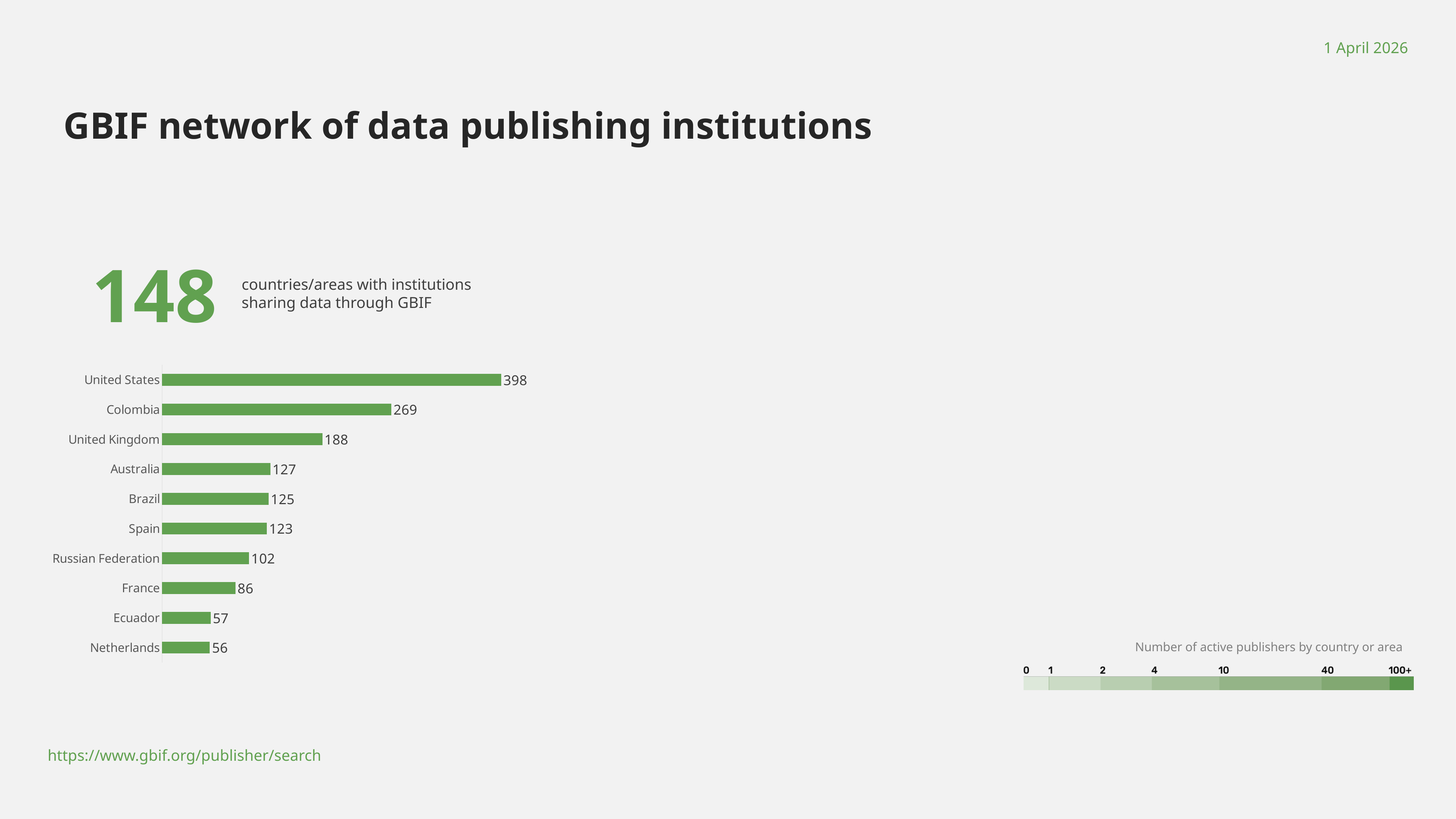
Which country has the highest value? United States Which is larger, the value for Australia or the value for Spain? Australia Which country has the lowest value? Netherlands What kind of chart is shown? bar chart How many countries are shown in the bar chart? 10 What is the difference between the values for United States and Colombia? 129 What is the value for United States? 398 What is the difference between the values for United Kingdom and France? 102 What is the value for Netherlands? 56 What is the value for Colombia? 269 What is the value for Russian Federation? 102 Do the values rise or fall going down the list of countries from United States to Netherlands? fall